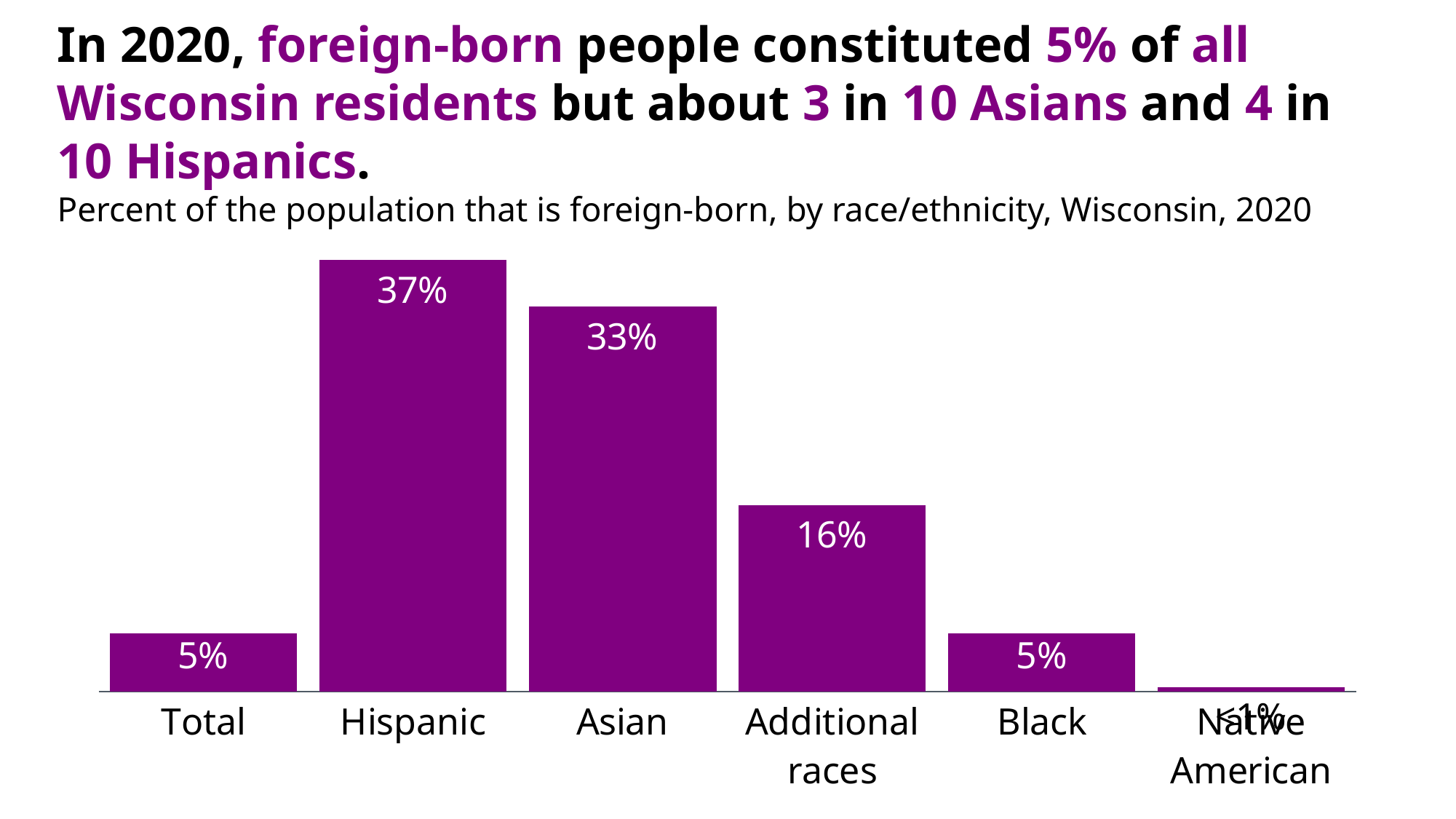
What is the difference between the Asian value and the Additional races value? 17% What is the difference between the Hispanic and Asian values? 4% What is the value shown for Total? 5% What percent of the Hispanic population is foreign-born? 37% Which race/ethnicity has the highest percent foreign-born? Hispanic Which race/ethnicity has the lowest percent foreign-born? Native American What kind of chart is shown on the slide? Bar chart What percent of the Asian population is foreign-born? 33% What is the value shown for Black? 5% How many race/ethnicity categories are shown in the chart? 6 Which is larger, the value for Additional races or the value for Black? Additional races What is the value shown for Additional races? 16%